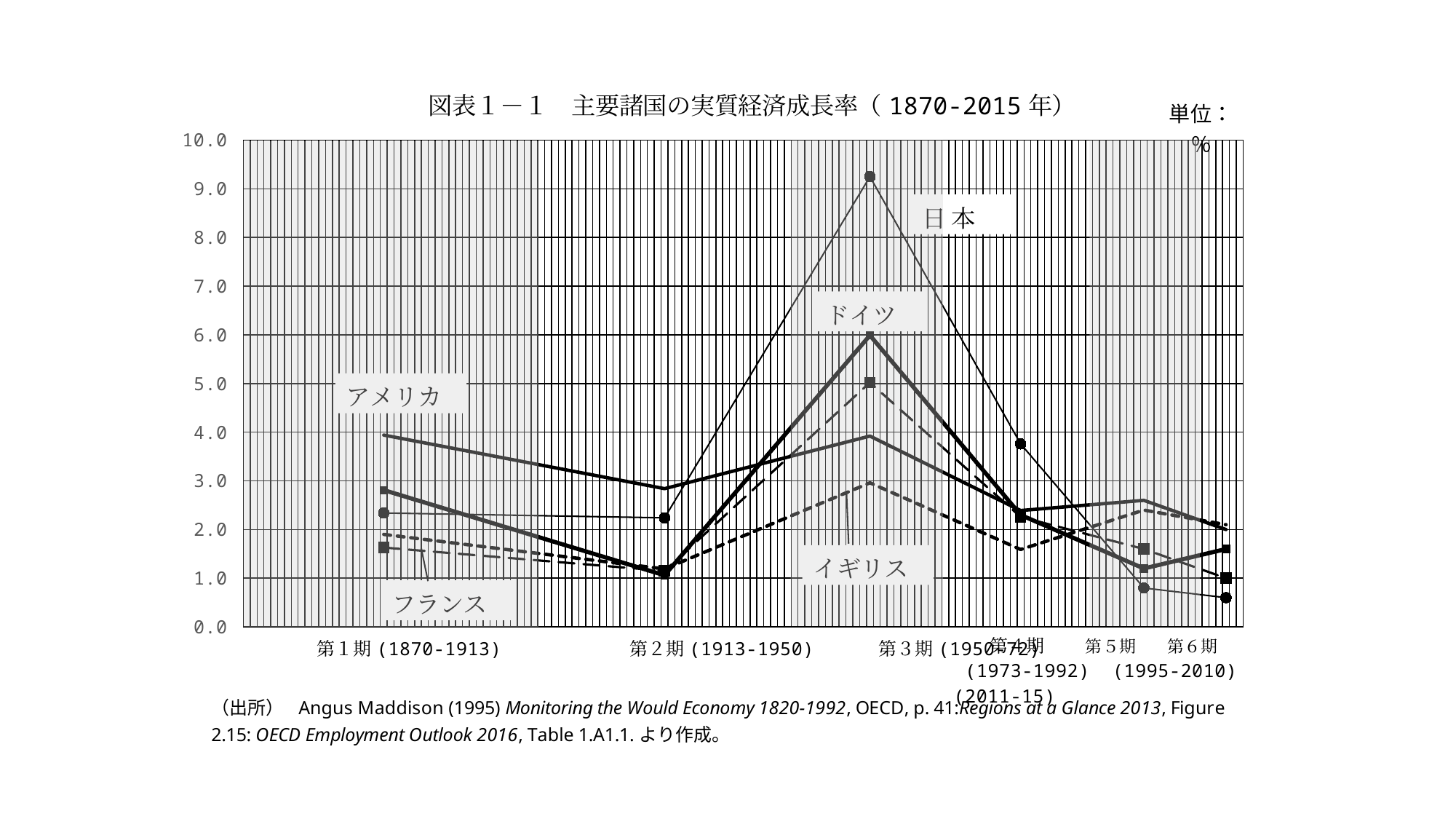
What kind of chart is shown on the slide? line chart Which country has the lowest growth rate in 第６期 (2011-15)? 日本 What unit is indicated for the values on the chart? % How many periods (期) are shown along the x axis? 6 How many countries are plotted on the chart? 5 Which country has the highest growth rate in 第１期 (1870-1913)? アメリカ Does the value for 日本 rise or fall from 第３期 to 第６期? fall Which country has the highest growth rate in 第３期 (1950-72)? 日本 Is the value for アメリカ in 第１期 (1870-1913) greater or less than 3.0? greater Is the value for 日本 in 第６期 (2011-15) greater or less than 1.0? less In 第３期 (1950-72), which is larger, the value for 日本 or the value for ドイツ? 日本 Is the value for 日本 in 第３期 (1950-72) greater or less than 8.0? greater